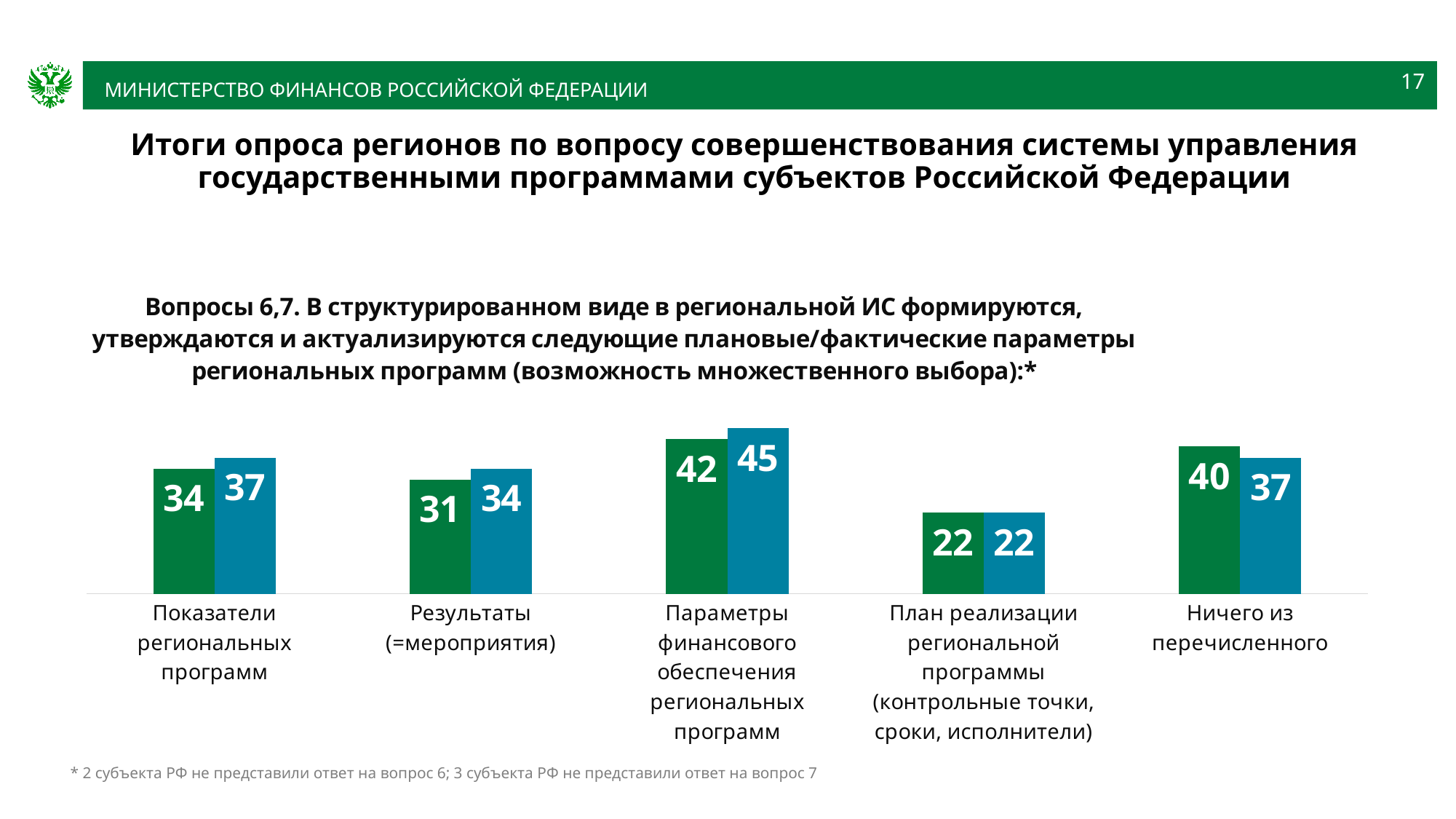
For «Ничего из перечисленного», which bar is larger, the green or the blue? green Which category has the lowest blue bar? План реализации региональной программы (контрольные точки, сроки, исполнители) What kind of chart is shown on the slide? bar chart How many categories are shown on the x axis of the chart? 5 How many bars are shown for each category in the chart? 2 What is the difference between the green bars for «Параметры финансового обеспечения региональных программ» and «План реализации региональной программы»? 20 What is the value of the blue bar for «Результаты (=мероприятия)»? 34 What is the value of the green bar for «Показатели региональных программ»? 34 Which category has the highest green bar? Параметры финансового обеспечения региональных программ What is the difference between the blue and green bars for «Показатели региональных программ»? 3 What is the value of the blue bar for «Параметры финансового обеспечения региональных программ»? 45 What is the value of the green bar for «Ничего из перечисленного»? 40